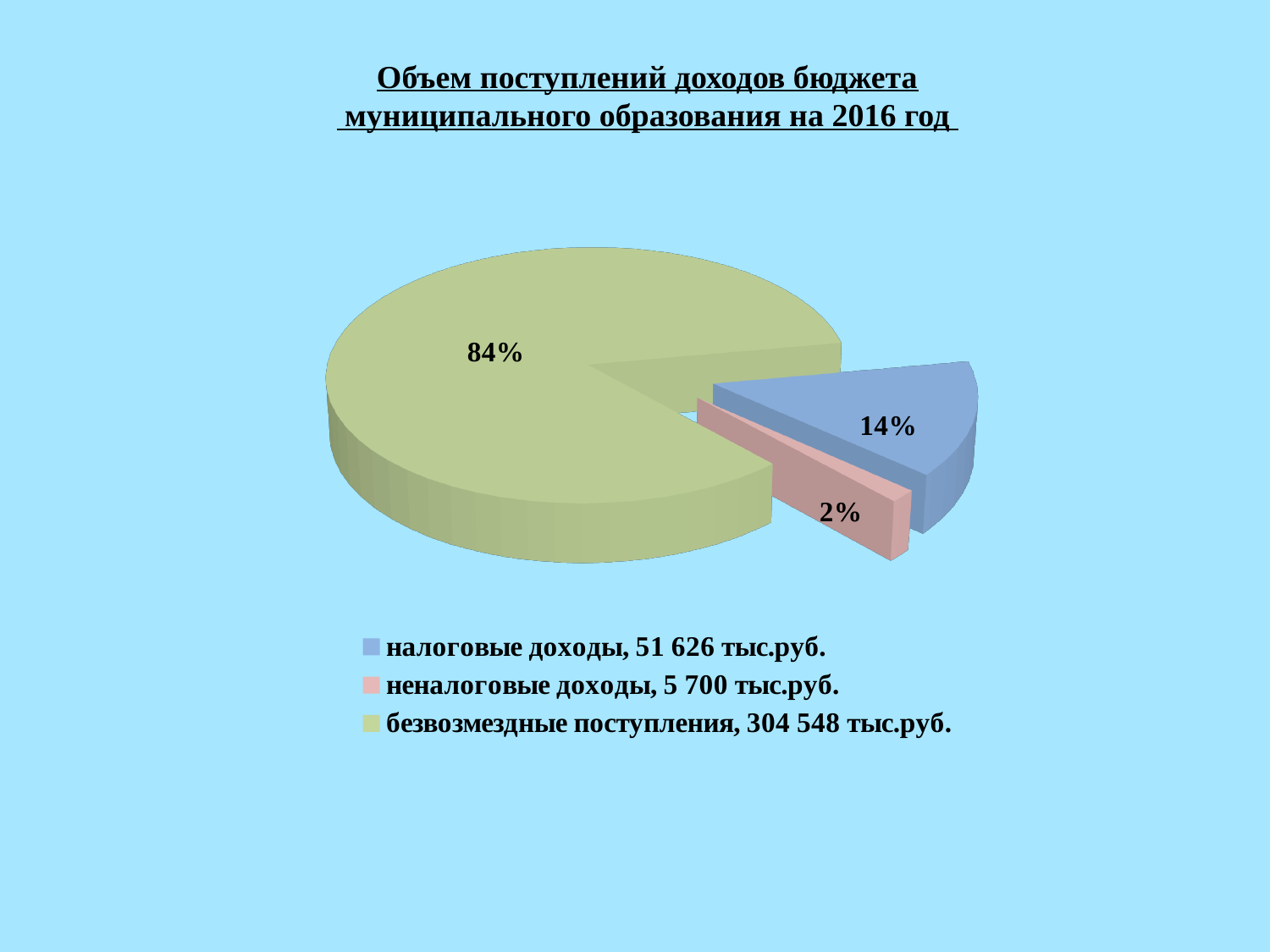
What share of the pie does безвозмездные поступления represent? 84% How many slices does the pie chart have? 3 What share of the pie does налоговые доходы represent? 14% What is the difference in percentage points between the безвозмездные поступления slice and the налоговые доходы slice? 70 percentage points Which category has the smallest slice of the pie? неналоговые доходы What is the value for налоговые доходы shown in the legend? 51 626 тыс.руб. What share of the pie does неналоговые доходы represent? 2% Which category has the largest slice of the pie? безвозмездные поступления What colour is the slice for неналоговые доходы? Pink What kind of chart is shown on the slide? Pie chart Which is larger, the share for налоговые доходы or the share for неналоговые доходы? налоговые доходы What is the value for безвозмездные поступления shown in the legend? 304 548 тыс.руб.